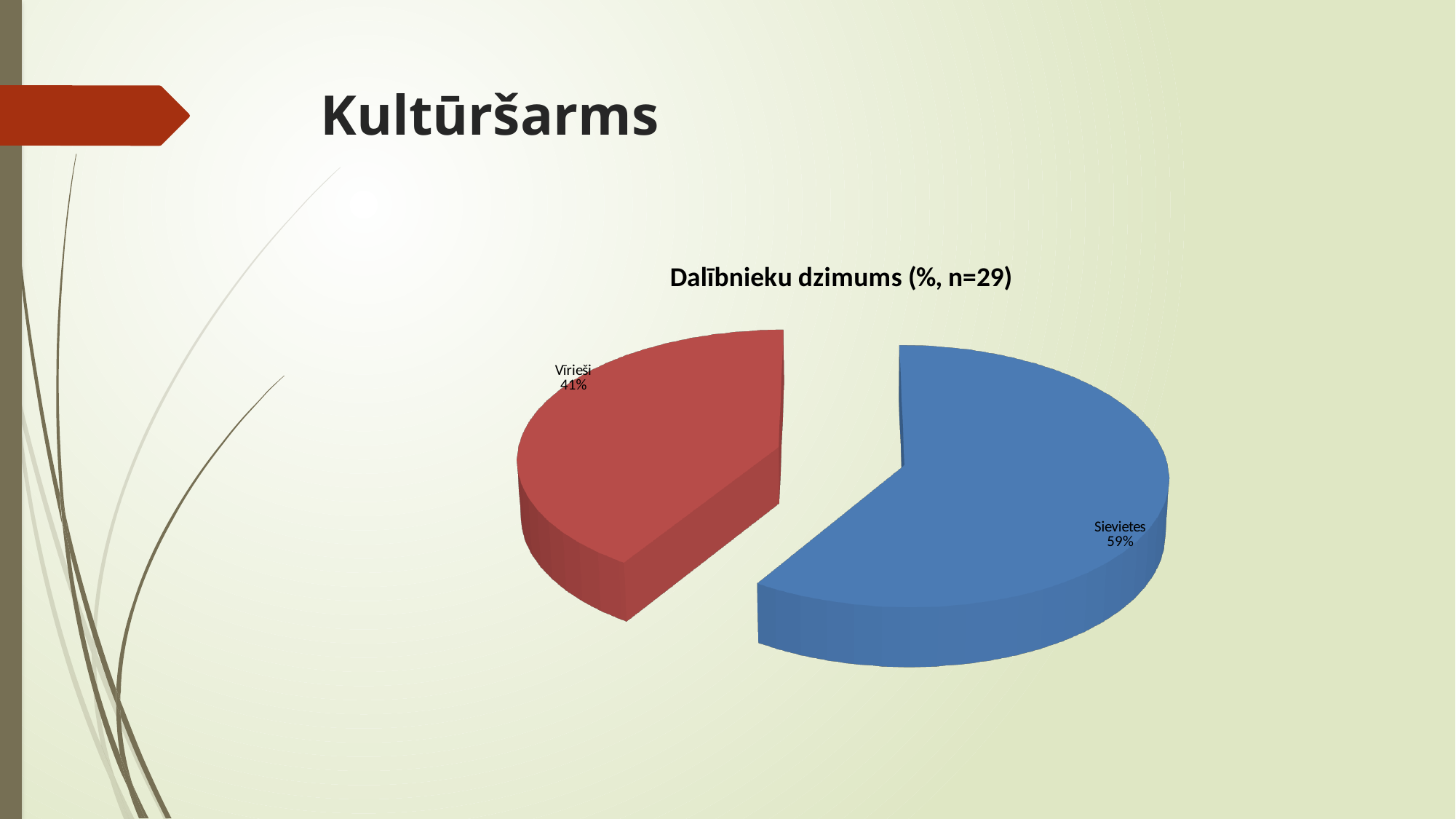
Which category has the largest share of the pie? Sievietes What percentage of participants are Vīrieši? 41% What colour is the Sievietes slice? Blue What percentage of participants are Sievietes? 59% What type of chart is shown on the slide? Pie chart What is the title of the chart? Dalībnieku dzimums (%, n=29) Which category has the smallest share of the pie? Vīrieši Which is larger, the share for Sievietes or the share for Vīrieši? Sievietes What is the difference in percentage points between Sievietes and Vīrieši? 18 What is the total of the two slices' percentages? 100% How many slices does the pie chart have? 2